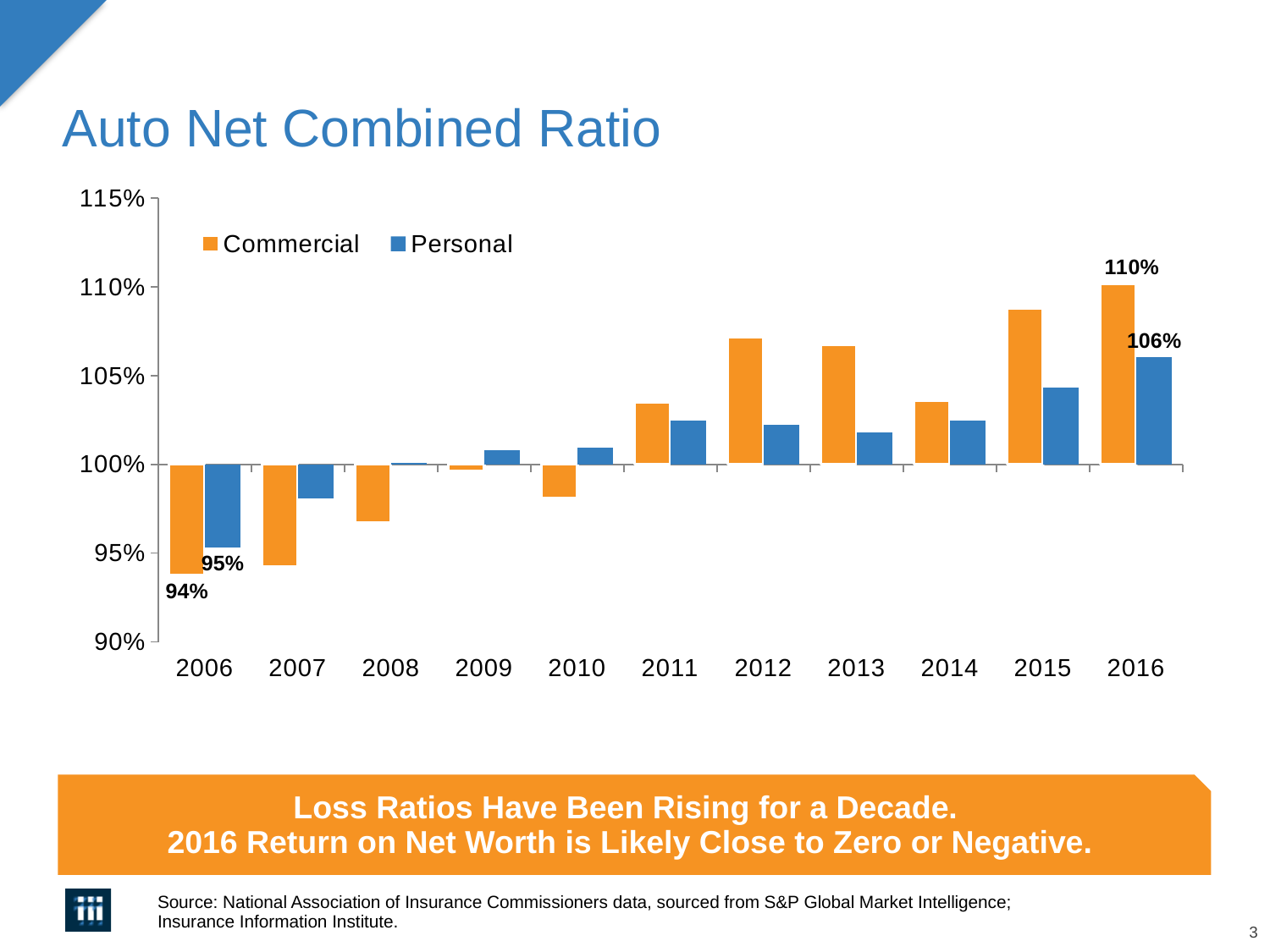
Is the Personal value for 2007 greater or less than 100%? less Is the Commercial value for 2012 greater or less than 105%? greater How many years are shown on the x axis? 11 What is the Commercial auto net combined ratio for 2006? 94% What is the Personal auto net combined ratio for 2016? 106% What is the Commercial auto net combined ratio for 2016? 110% How many series does the legend list? 2 By how many percentage points does the Commercial ratio exceed the Personal ratio in 2016? 4 percentage points What kind of chart is shown on the slide? Bar chart What is the Personal auto net combined ratio for 2006? 95% Which colour represents the Commercial series in the legend? Orange In which year is the Commercial combined ratio highest? 2016